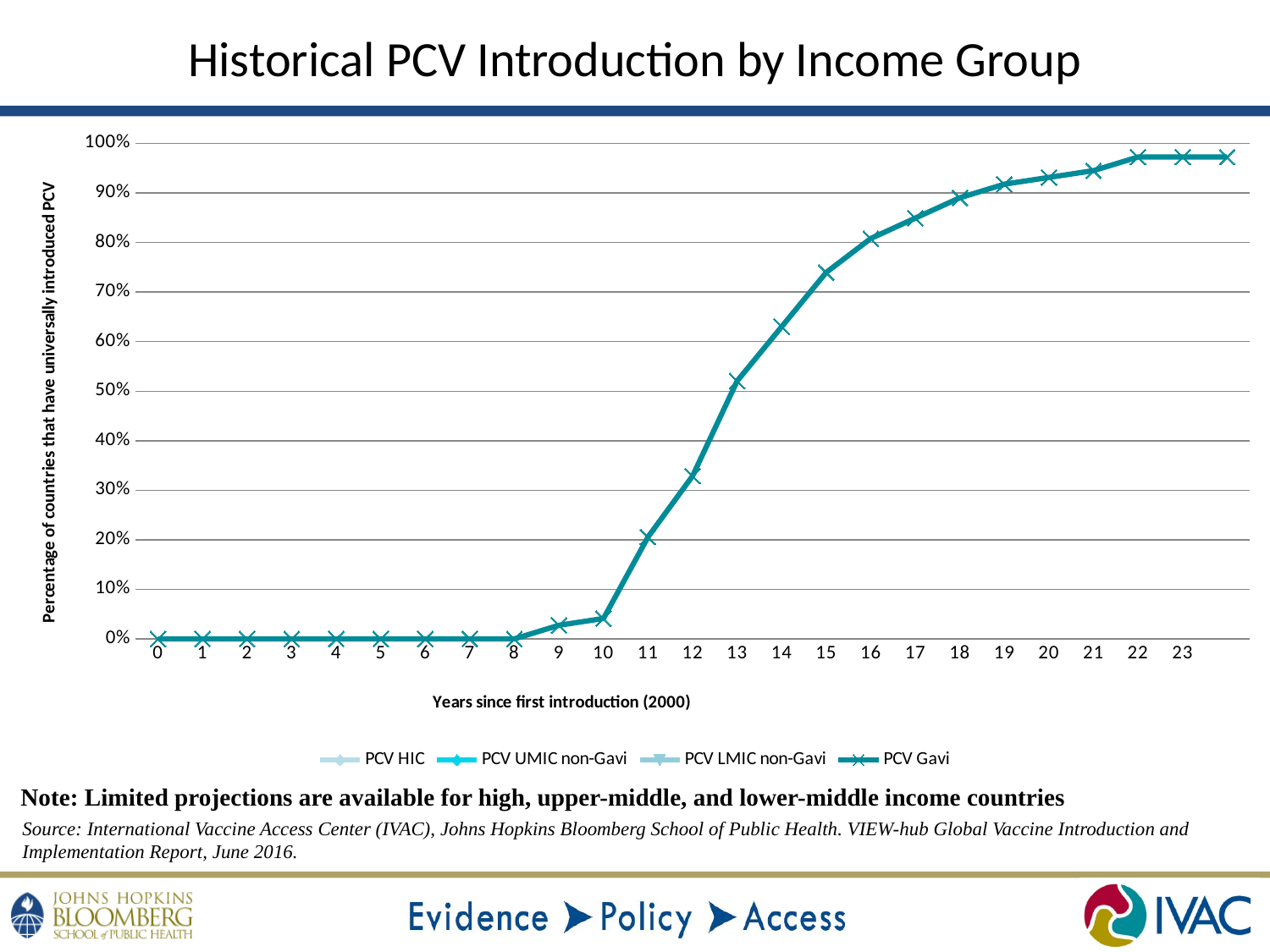
How many series does the legend list? 4 What is the title of the chart? Historical PCV Introduction by Income Group What is the value for PCV Gavi at 0 years since first introduction? 0% Is the value for PCV Gavi at year 22 greater or less than 90%? greater Is the value for PCV Gavi at year 13 greater or less than 50%? greater Which is larger for PCV Gavi: the value at year 12 or the value at year 14? year 14 What type of chart is shown on the slide? line chart Is the value for PCV Gavi at year 10 greater or less than 10%? less What is the label of the x axis? Years since first introduction (2000) Does the PCV Gavi line rise or fall as years since first introduction increase? rise What is the value for PCV Gavi at 5 years since first introduction? 0%